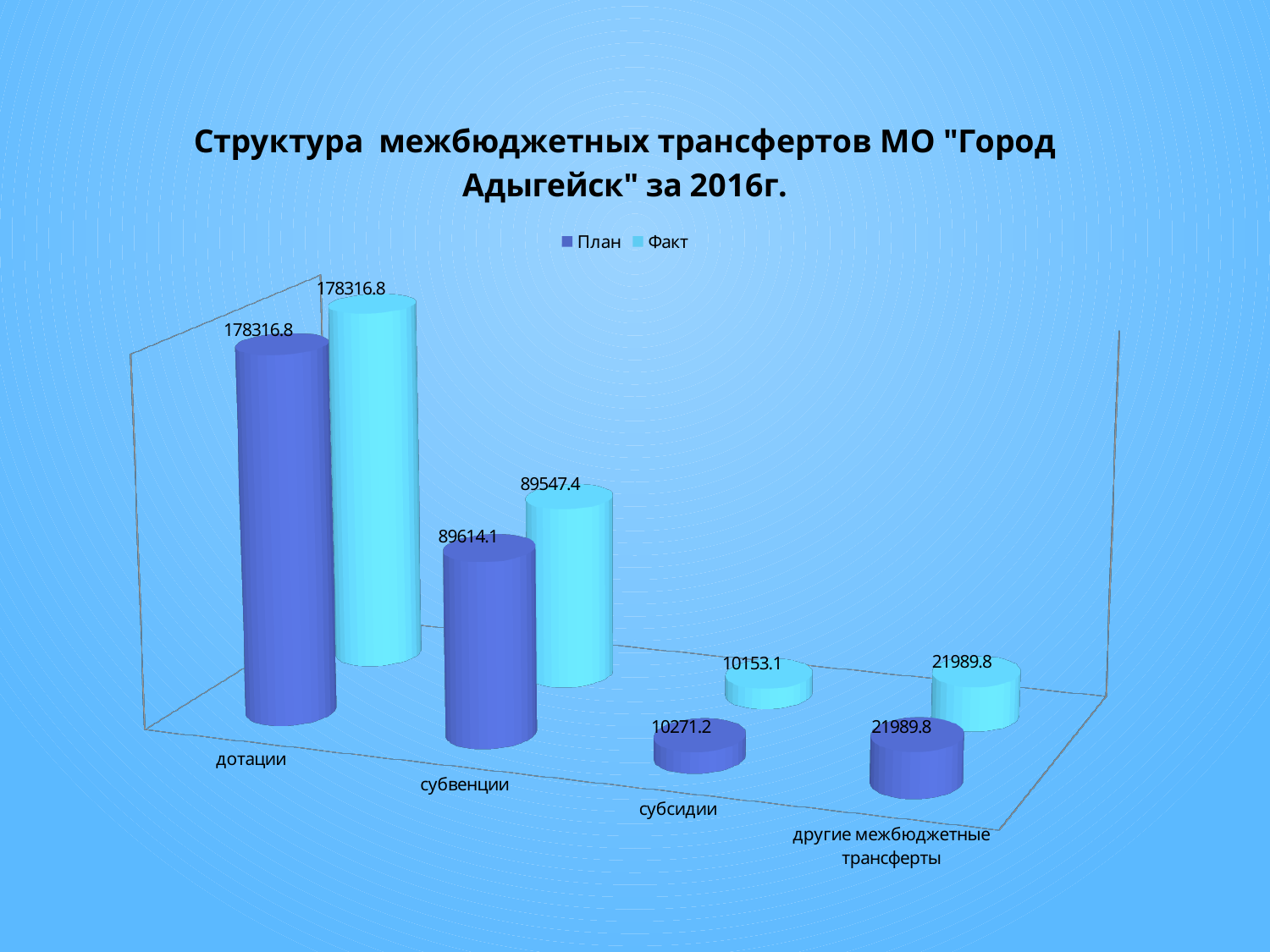
What kind of chart is shown on the slide? bar chart What is the План value for субсидии? 10271.2 For субсидии, which is larger: the План value or the Факт value? План What is the План value for дотации? 178316.8 Which category has the highest Факт value? дотации What is the Факт value for субвенции? 89547.4 What is the difference between the План and Факт values for субвенции? 66.7 What is the difference between the План and Факт values for субсидии? 118.1 How many categories are shown on the x axis? 4 What is the Факт value for другие межбюджетные трансферты? 21989.8 How many series does the legend list? 2 Which category has the lowest План value? субсидии